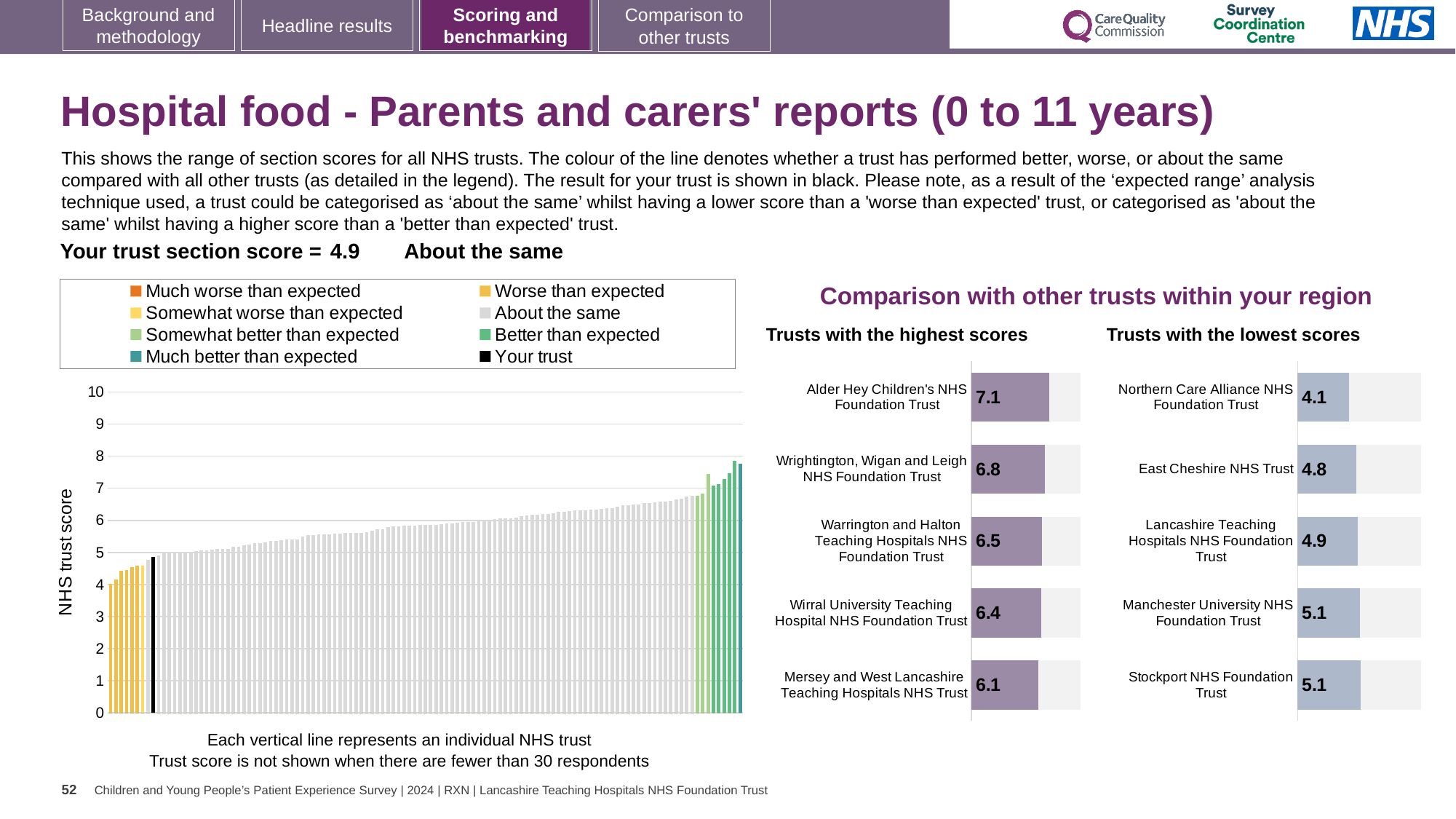
What kind of chart is the large 'NHS trust score' chart on the left? Bar chart In the 'Trusts with the lowest scores' chart, what is the difference between the scores of East Cheshire NHS Trust and Northern Care Alliance NHS Foundation Trust? 0.7 How many trusts are listed in the 'Trusts with the highest scores' chart? 5 In the 'Trusts with the highest scores' chart, what is the difference between the scores of Alder Hey Children's NHS Foundation Trust and Mersey and West Lancashire Teaching Hospitals NHS Trust? 1.0 In the 'Trusts with the lowest scores' chart, which trust has the lowest score? Northern Care Alliance NHS Foundation Trust In the 'Trusts with the highest scores' chart, what is the score for Alder Hey Children's NHS Foundation Trust? 7.1 In the 'Trusts with the highest scores' chart, which trust has the highest score? Alder Hey Children's NHS Foundation Trust In the large 'NHS trust score' chart on the left, is the value of the tallest bar greater or less than 7? greater How many entries does the legend of the large 'NHS trust score' chart on the left list? 8 In the 'Trusts with the lowest scores' chart, what is the score for Northern Care Alliance NHS Foundation Trust? 4.1 In the large 'NHS trust score' chart on the left, do the bar values rise or fall from left to right? Rise In the 'Trusts with the lowest scores' chart, which has the higher score: Lancashire Teaching Hospitals NHS Foundation Trust or East Cheshire NHS Trust? Lancashire Teaching Hospitals NHS Foundation Trust